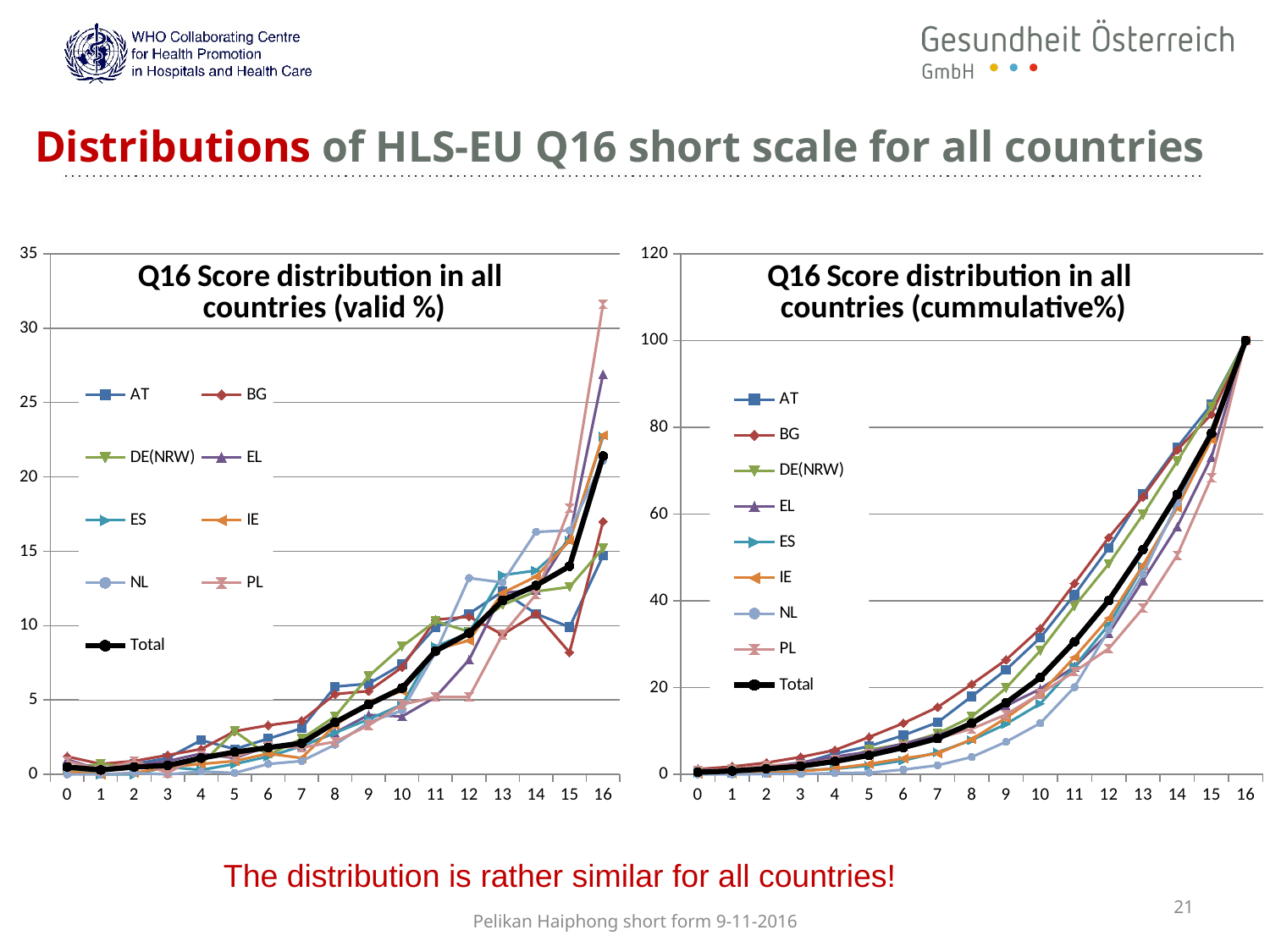
In the 'Q16 Score distribution in all countries (valid %)' chart, which series has the highest value at score 16? PL How many series does the legend of the 'Q16 Score distribution in all countries (cummulative%)' chart list? 9 In the 'Q16 Score distribution in all countries (cummulative%)' chart, is the value for BG at score 12 greater or less than 50? greater In the 'Q16 Score distribution in all countries (valid %)' chart, is the value for PL at score 16 greater or less than 30? greater In the 'Q16 Score distribution in all countries (cummulative%)' chart, do the values rise or fall as the score increases from 0 to 16? rise In the 'Q16 Score distribution in all countries (valid %)' chart, which series has the lowest value at score 15? BG In the 'Q16 Score distribution in all countries (cummulative%)' chart, is the value for NL at score 10 greater or less than 20? less What kind of chart is the 'Q16 Score distribution in all countries (valid %)' chart on the left? line chart How many score points are plotted along the x axis of the 'Q16 Score distribution in all countries (valid %)' chart? 17 In the 'Q16 Score distribution in all countries (cummulative%)' chart, which is larger at score 12, BG or PL? BG